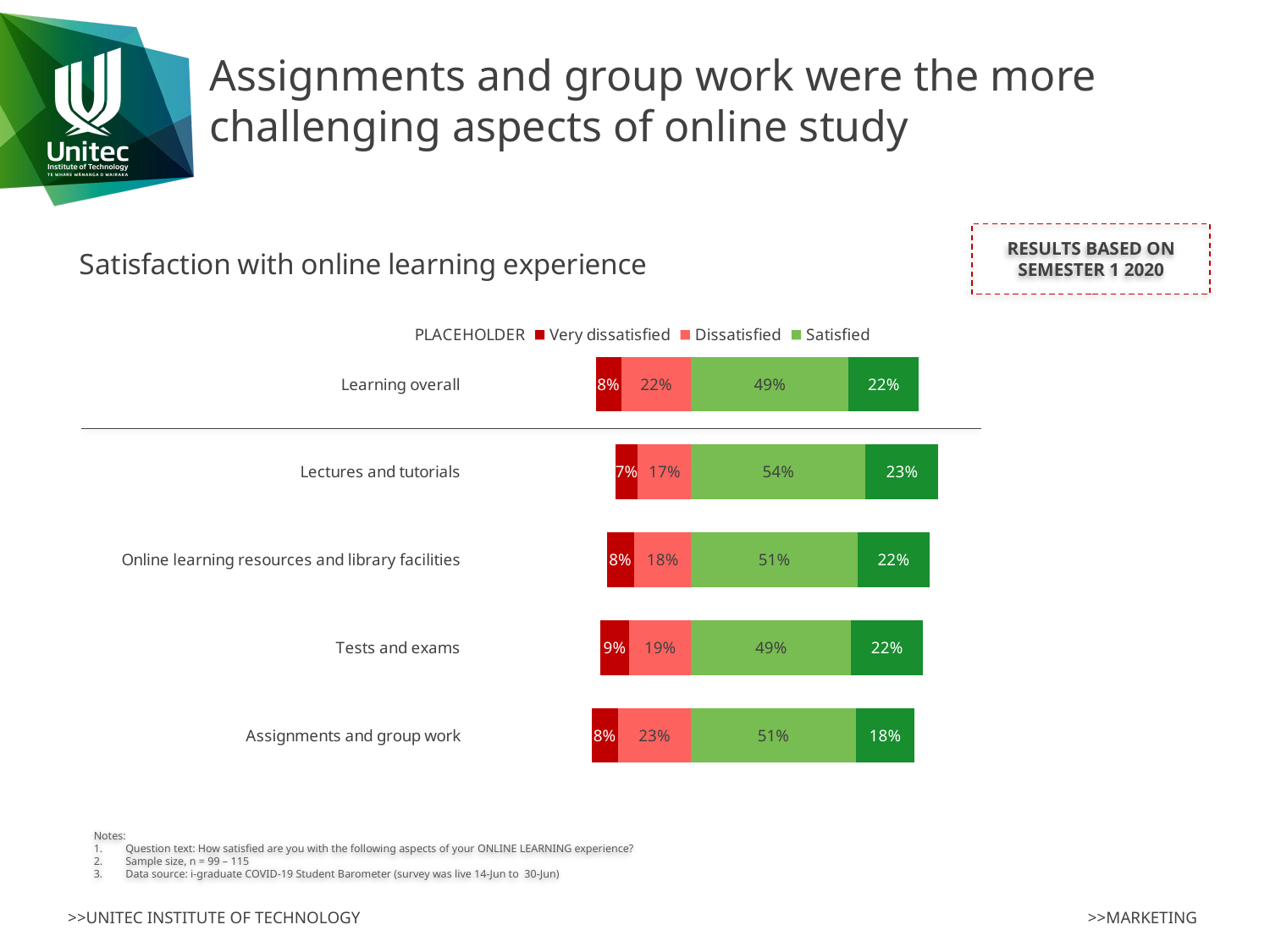
Which category has the highest Satisfied value? Lectures and tutorials What is the Very dissatisfied value for Tests and exams? 9% How many entries does the legend list? 4 What kind of chart is shown on the slide? Stacked bar chart What is the Satisfied value for Lectures and tutorials? 54% Which category has the lowest Very dissatisfied value? Lectures and tutorials What is the total of the labelled segments in the Assignments and group work bar? 100% What is the Dissatisfied value for Assignments and group work? 23% What is the difference between the Dissatisfied values for Assignments and group work and Lectures and tutorials? 6 percentage points How many categories are shown in the chart? 5 Which has the larger Satisfied value, Lectures and tutorials or Tests and exams? Lectures and tutorials Which category has the highest Dissatisfied value? Assignments and group work